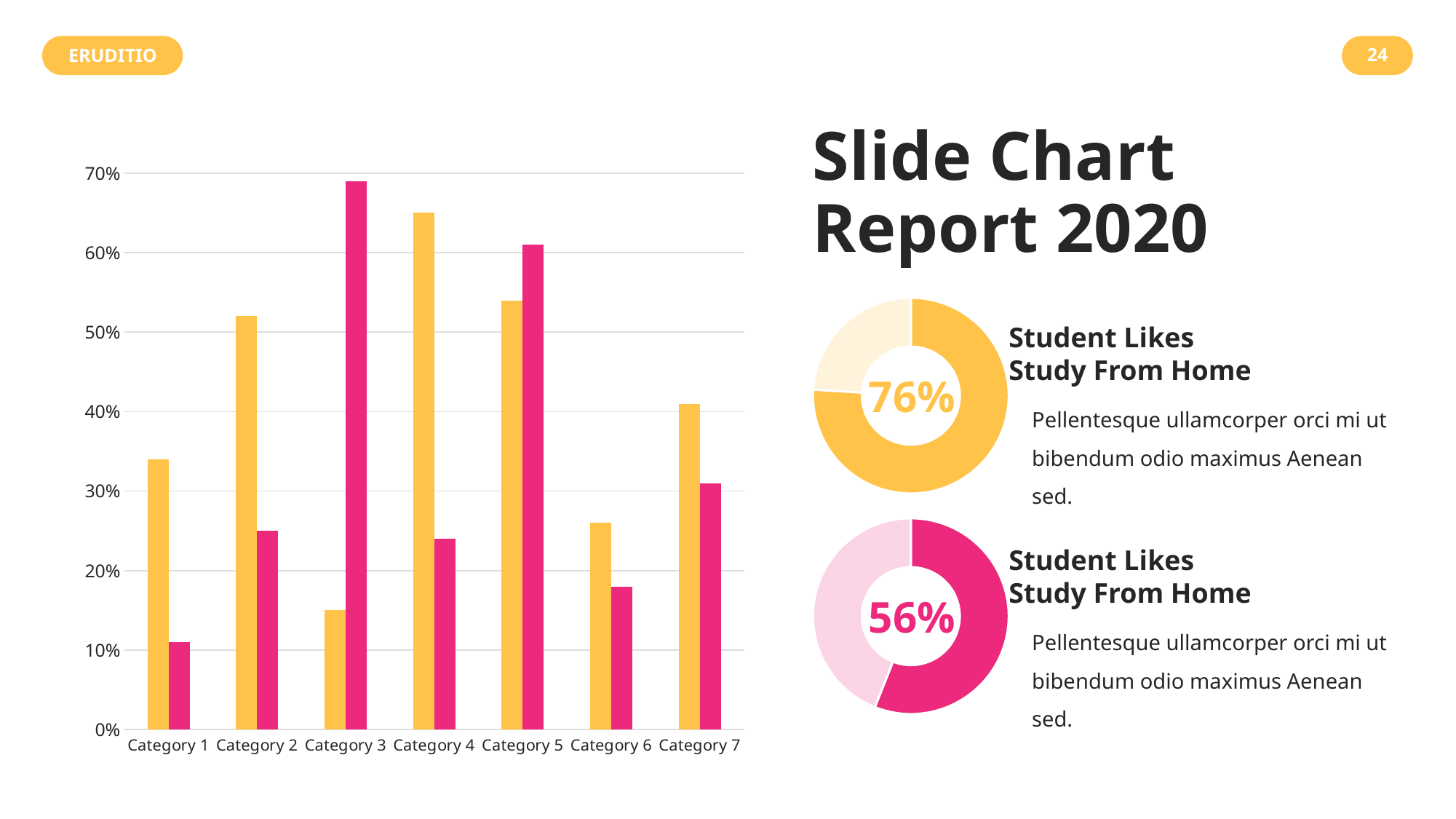
In the bar chart, is the pink bar for Category 3 greater or less than 60%? greater What percentage is shown in the centre of the lower (pink) donut chart? 56% In the bar chart, which category has the shortest pink bar? Category 1 In the bar chart, which category has the tallest pink bar? Category 3 What kind of chart is shown on the left side of the slide? Bar chart In the bar chart, is the yellow bar for Category 3 greater or less than 20%? less In the bar chart, for Category 2, which bar is taller, the yellow one or the pink one? The yellow one In the bar chart, is the yellow bar for Category 1 greater or less than 30%? greater How many categories are shown on the x axis of the bar chart? 7 In the bar chart, which category has the shortest yellow bar? Category 3 In the bar chart, which category has the tallest yellow bar? Category 4 What percentage is shown in the centre of the upper (yellow) donut chart? 76%